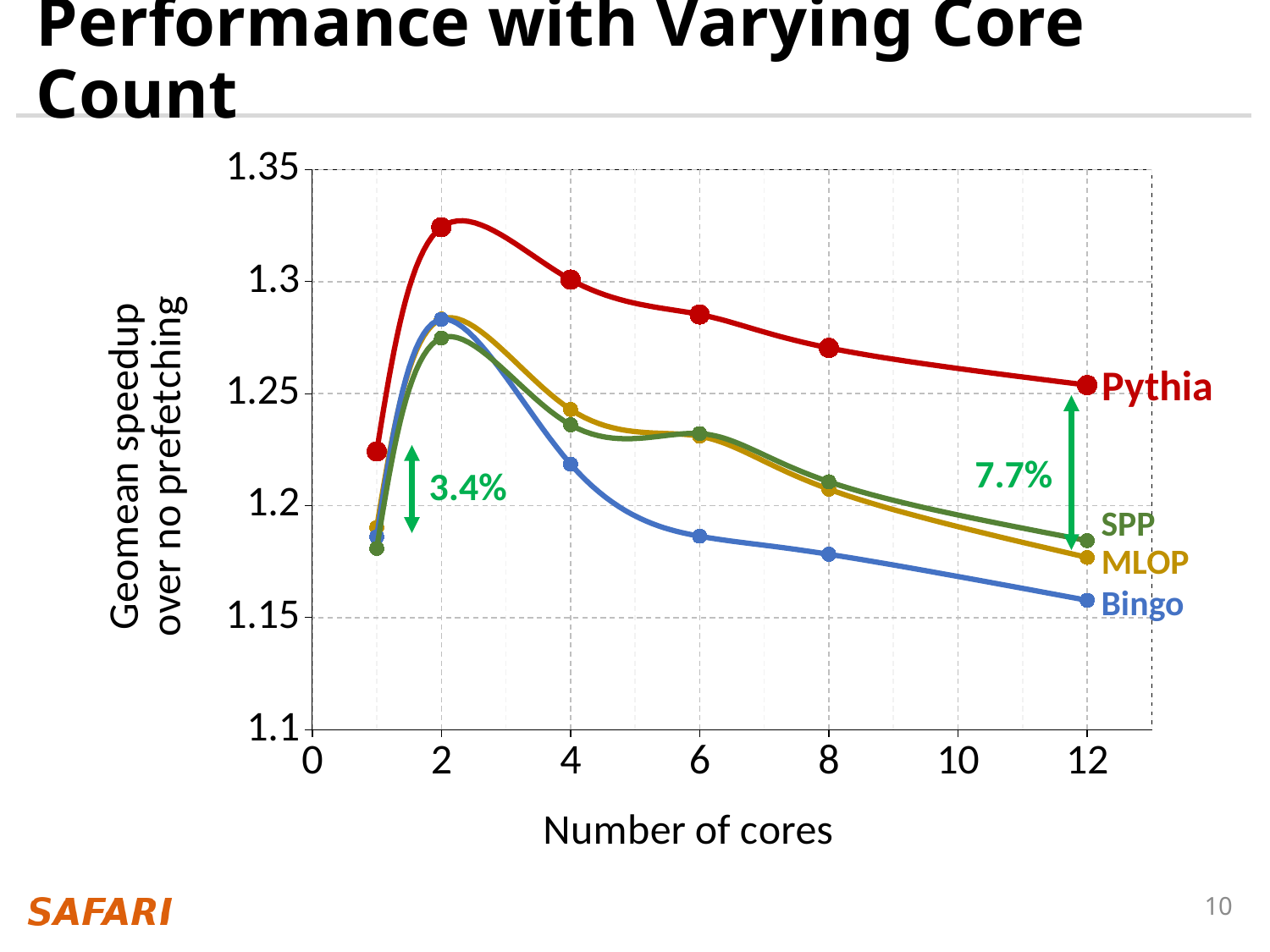
Is the geomean speedup for SPP at 6 cores greater or less than 1.25? less What percentage improvement is annotated between Pythia and SPP at 12 cores? 7.7% How many prefetchers (series) are plotted in the chart? 4 What kind of chart is shown on the slide? line chart Is the geomean speedup for Bingo at 12 cores greater or less than 1.2? less What is the label of the x axis? Number of cores Does the geomean speedup for Pythia rise or fall as the number of cores increases from 2 to 12? falls At 4 cores, which has the higher geomean speedup, Pythia or Bingo? Pythia How many core-count data points are plotted for each prefetcher? 6 Which prefetcher has the lowest geomean speedup at 12 cores? Bingo Is the geomean speedup for Pythia at 2 cores greater or less than 1.3? greater Which prefetcher has the highest geomean speedup at 12 cores? Pythia